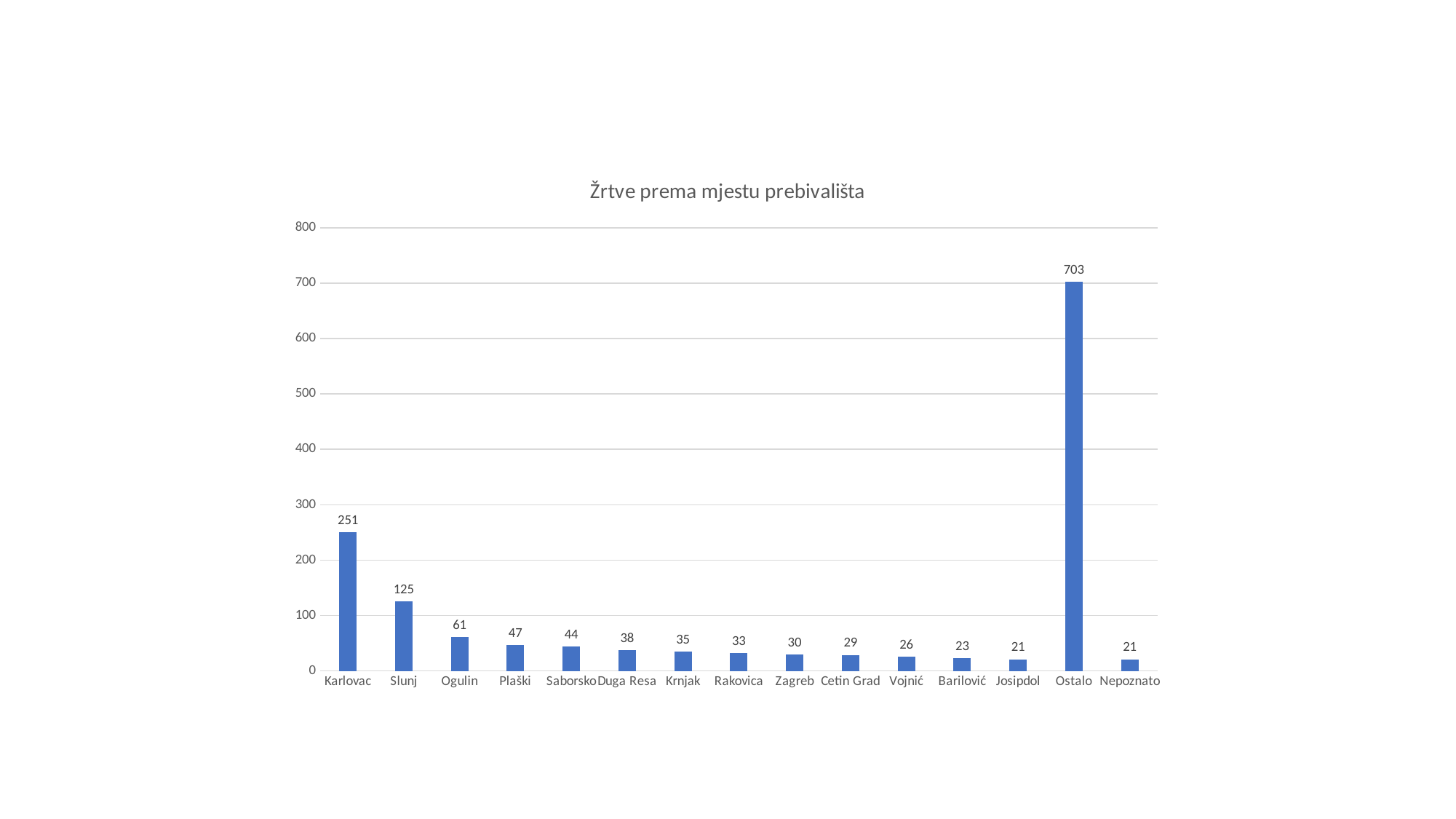
Which is larger, the value for Plaški or the value for Saborsko? Plaški What is the difference between the values for Karlovac and Slunj? 126 Is the value for Ostalo greater or less than 600? greater Which category has the highest value? Ostalo How many categories are shown on the x axis? 15 What is the difference between the values for Ostalo and Karlovac? 452 What is the value for Karlovac? 251 What is the title of the chart? Žrtve prema mjestu prebivališta What is the value for Slunj? 125 What is the value for Ogulin? 61 What is the value for Nepoznato? 21 What kind of chart is shown on the slide? bar chart